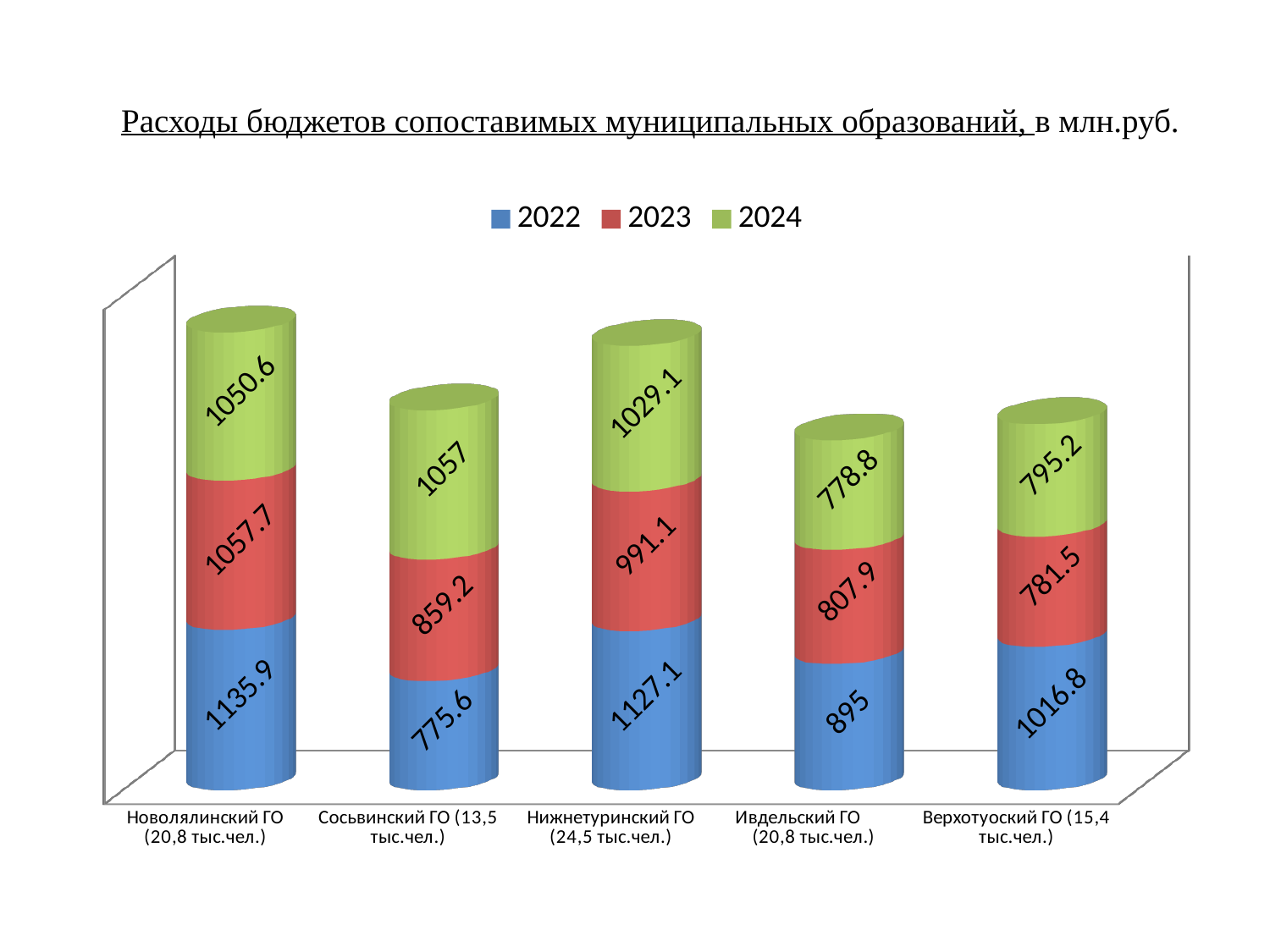
What kind of chart is shown on the slide? Stacked bar chart What is the 2023 value for Ивдельский ГО? 807.9 What is the 2022 value for Верхотуоский ГО? 1016.8 How many series does the legend list? 3 Which municipality has the highest 2022 value? Новолялинский ГО How many municipalities are shown on the x axis? 5 What is the difference between the 2023 values for Новолялинский ГО and Сосьвинский ГО? 198.5 What is the 2024 value for Сосьвинский ГО? 1057 Which municipality has the lowest 2024 value? Ивдельский ГО What is the 2022 value for Новолялинский ГО? 1135.9 Which is larger: the 2024 value for Нижнетуринский ГО or the 2024 value for Верхотуоский ГО? Нижнетуринский ГО What is the total of the stacked bar for Ивдельский ГО? 2481.7